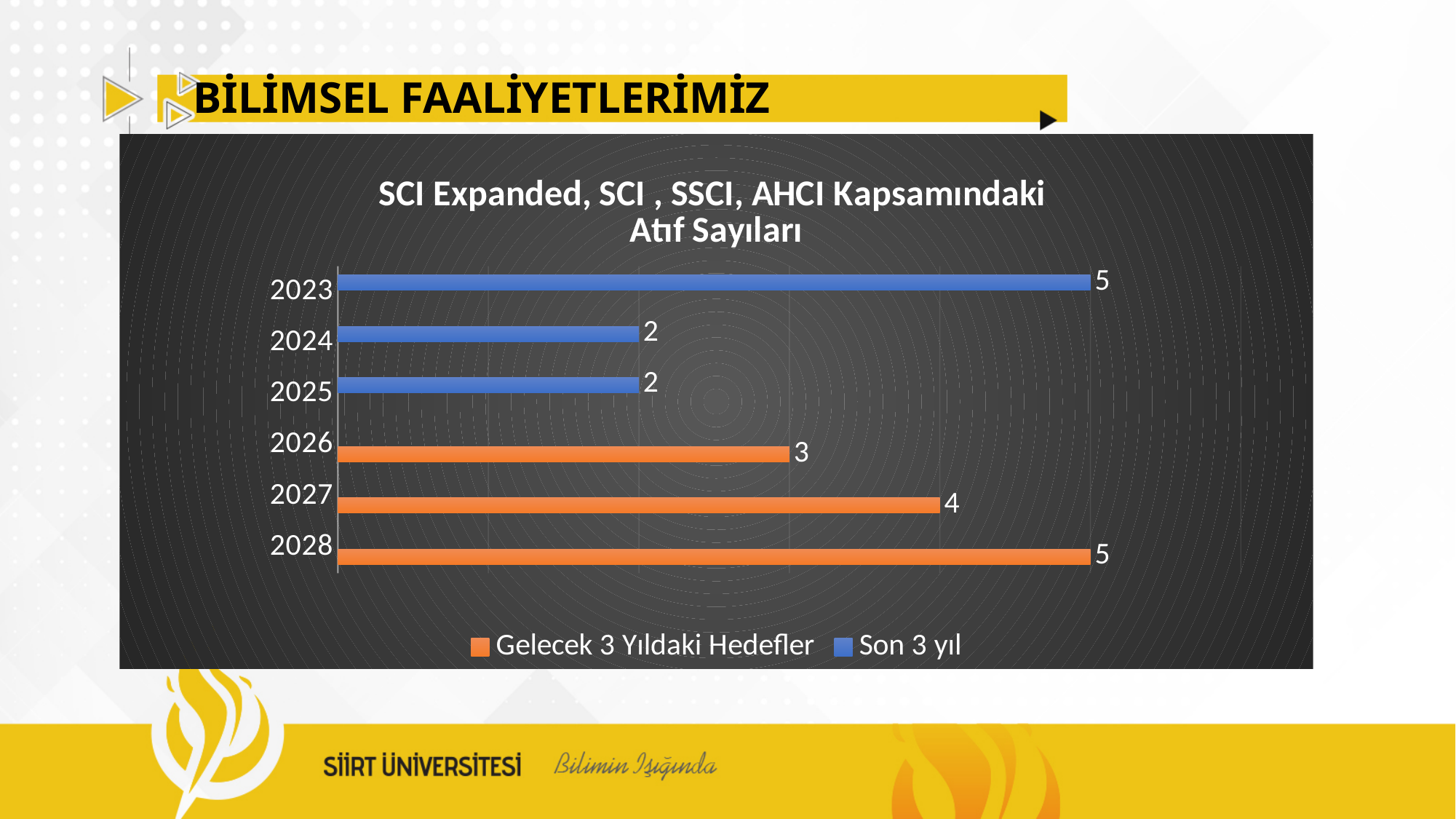
Which is larger, the value for 2027 or the value for 2025? 2027 How many series does the legend list? 2 What is the value for 2024 in the chart? 2 What kind of chart is shown on the slide? Bar chart What is the value for 2023 in the chart? 5 Which year has the lowest value among the 'Gelecek 3 Yıldaki Hedefler' bars? 2026 How many years are shown on the chart? 6 What is the value for 2027 in the chart? 4 Which year has the highest value among the 'Son 3 yıl' bars? 2023 What is the value for 2028 in the chart? 5 What is the value for 2026 in the chart? 3 What is the difference between the values for 2023 and 2024? 3